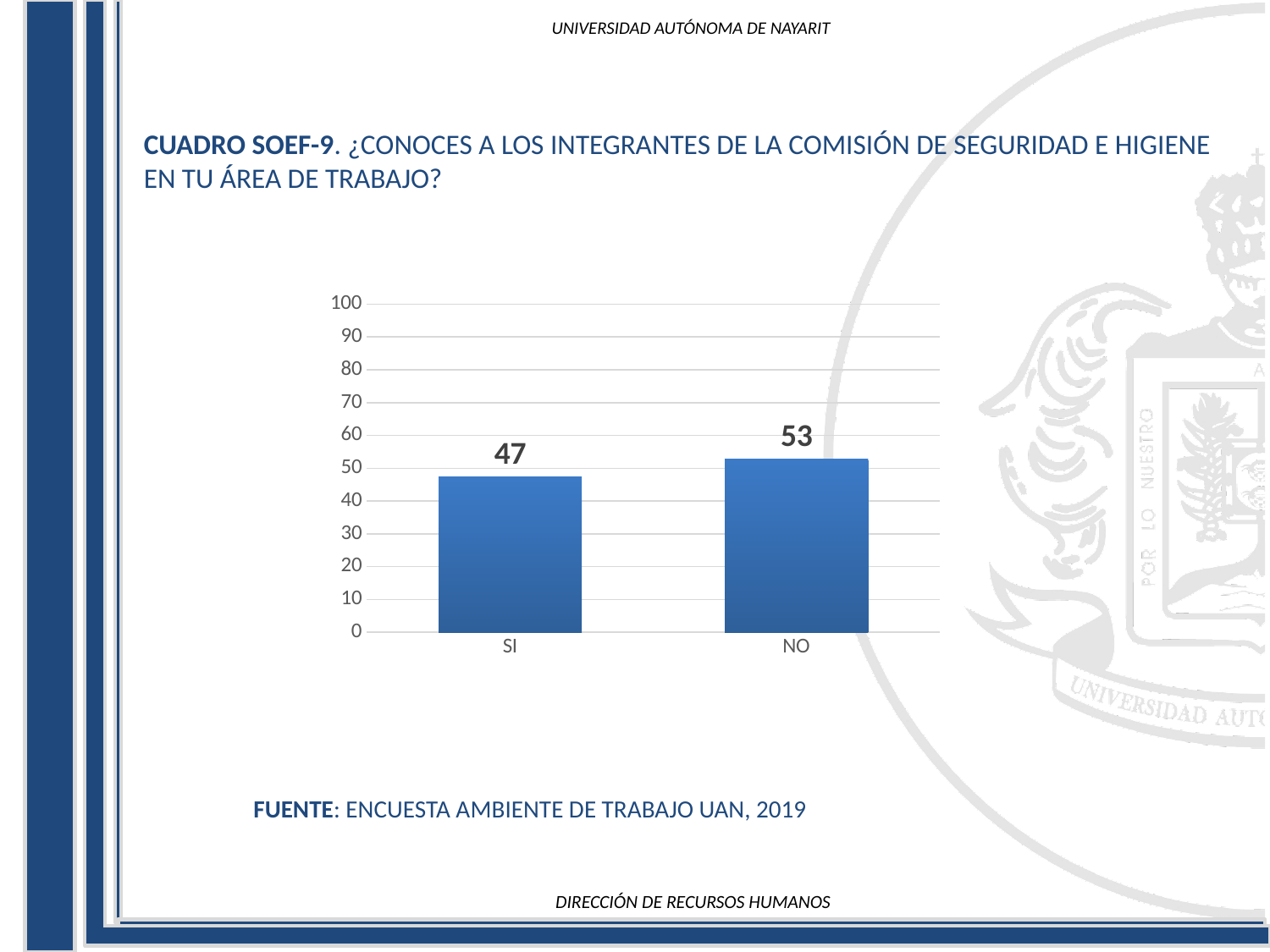
What is the value for NO? 53 What is the maximum value shown on the y axis? 100 What kind of chart is shown on the slide? bar chart Is the value for NO greater or less than 50? greater Which category has the lowest value? SI Is the value for SI greater or less than 50? less What is the total of the two bars? 100 What is the value for SI? 47 How many categories are shown on the x axis? 2 Which is larger, the value for SI or the value for NO? NO Which category has the highest value? NO What is the difference between the values for NO and SI? 6